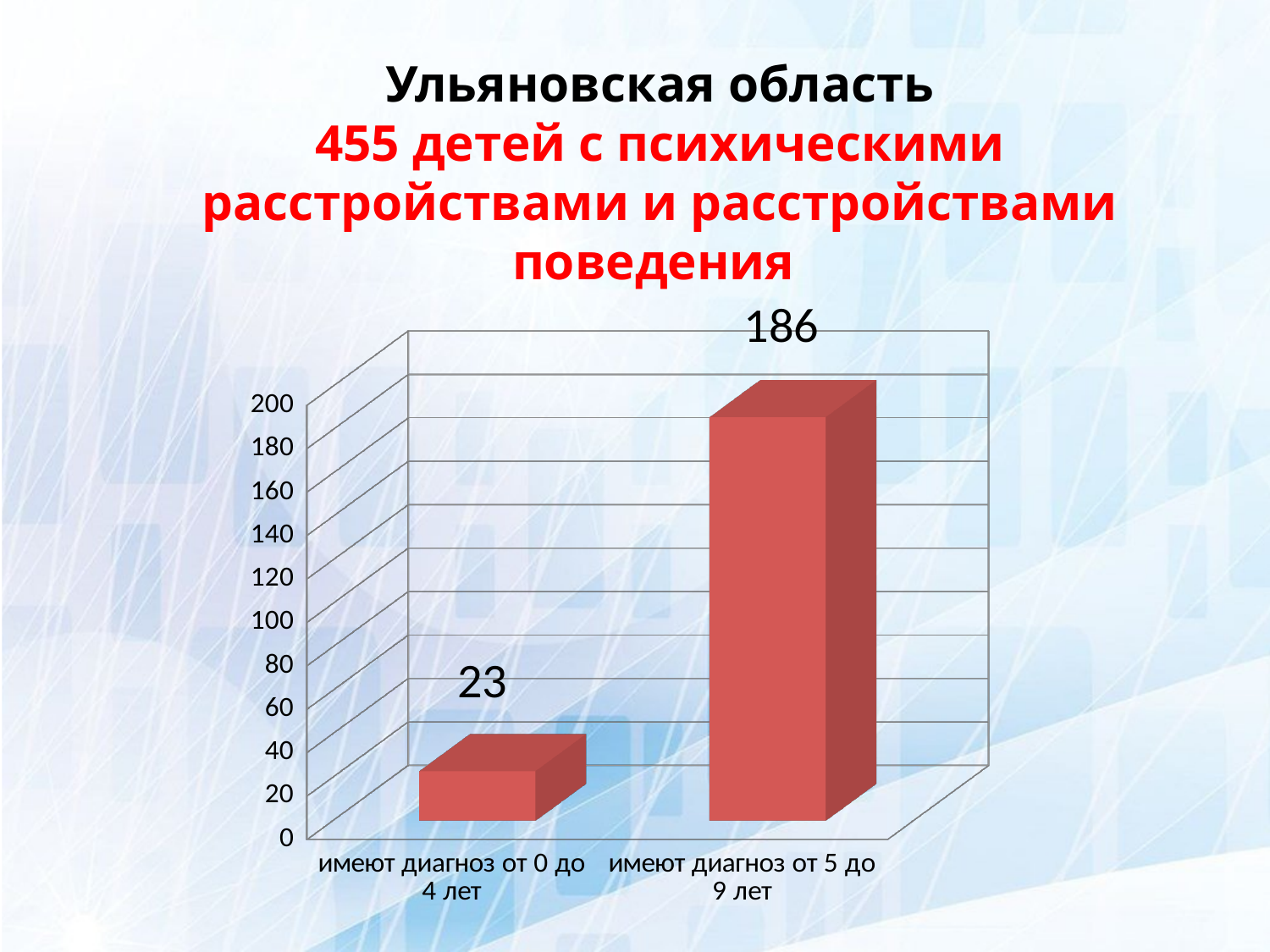
Is the value for "имеют диагноз от 5 до 9 лет" greater or less than 100? greater What is the difference between the values for "имеют диагноз от 5 до 9 лет" and "имеют диагноз от 0 до 4 лет"? 163 What is the value for "имеют диагноз от 0 до 4 лет"? 23 Which is larger: the value for "имеют диагноз от 0 до 4 лет" or for "имеют диагноз от 5 до 9 лет"? имеют диагноз от 5 до 9 лет Which category has the highest value? имеют диагноз от 5 до 9 лет What kind of chart is shown on the slide? bar chart What is the maximum value shown on the vertical axis? 200 What is the value for "имеют диагноз от 5 до 9 лет"? 186 Which category has the lowest value? имеют диагноз от 0 до 4 лет What colour are the bars in the chart? red Is the value for "имеют диагноз от 0 до 4 лет" greater or less than 40? less How many categories are shown in the chart? 2